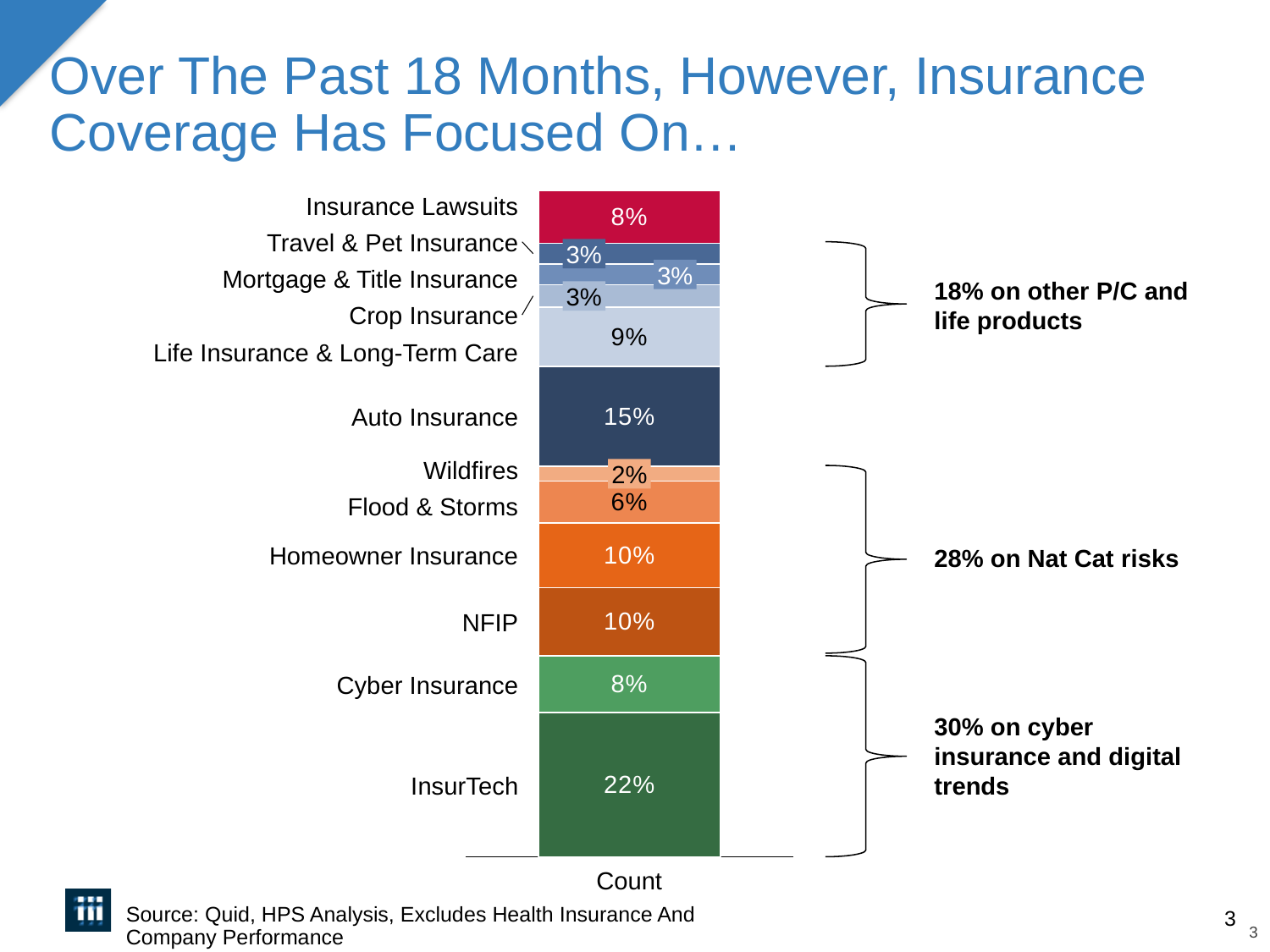
Which category has the smallest share of coverage? Wildfires What percentage of coverage is attributed to Life Insurance & Long-Term Care? 9% What percentage of coverage is attributed to InsurTech? 22% What kind of chart is shown on the slide? Stacked bar chart What percentage of coverage is attributed to Auto Insurance? 15% Which category has the largest share of coverage? InsurTech What label is shown on the horizontal axis beneath the bar? Count What percentage of coverage is attributed to Flood & Storms? 6% What is the combined share of Wildfires, Flood & Storms, Homeowner Insurance and NFIP? 28% Which has a larger share of coverage, Auto Insurance or Homeowner Insurance? Auto Insurance How many categories are shown in the stacked bar? 12 How many percentage points larger is InsurTech's share than Auto Insurance's share? 7 percentage points